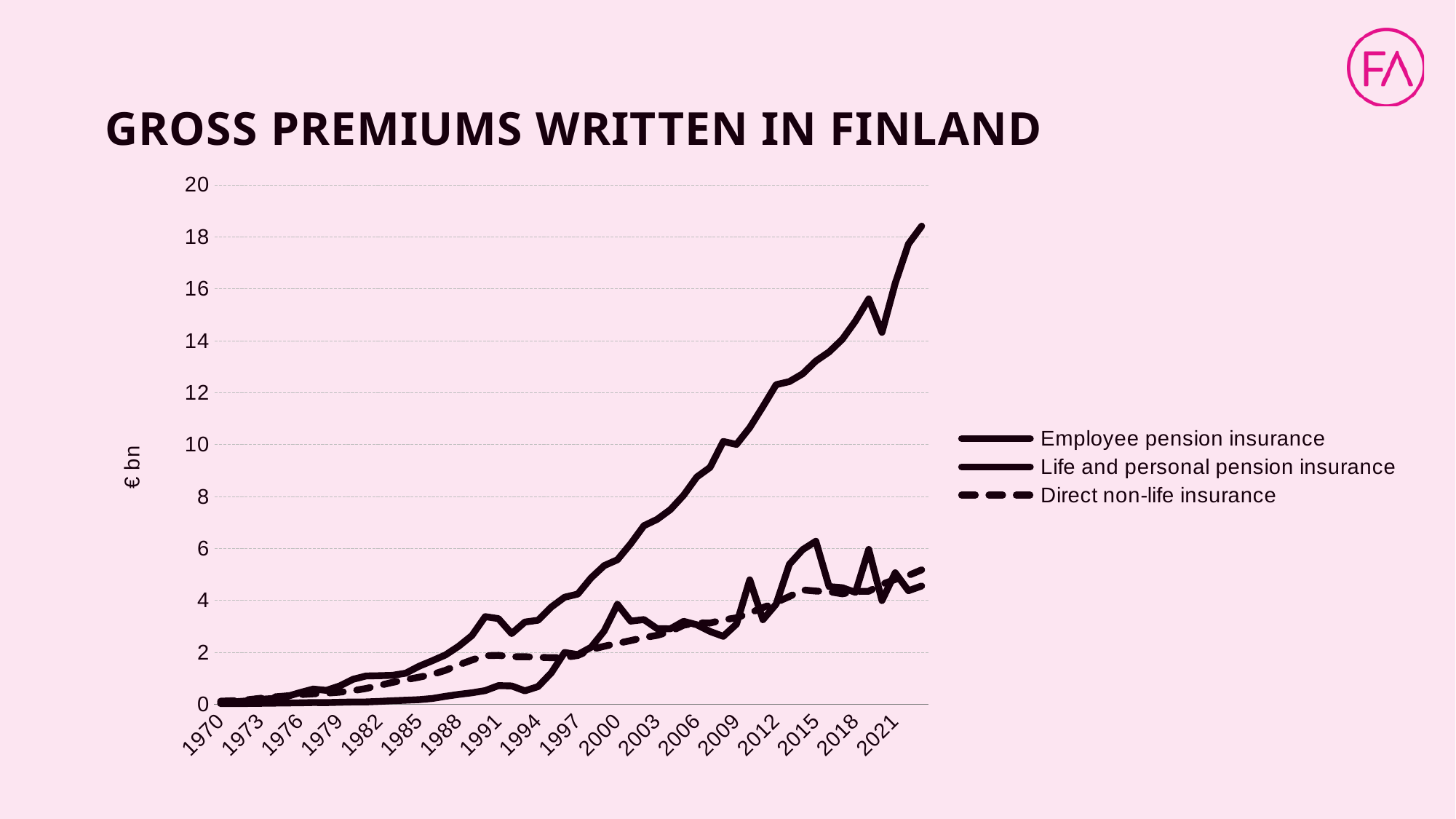
Which series is drawn with a dashed line? Direct non-life insurance What is the title of the chart? GROSS PREMIUMS WRITTEN IN FINLAND In 2021, which is larger: Employee pension insurance or Direct non-life insurance? Employee pension insurance What is the label on the vertical axis? € bn Is the value for Direct non-life insurance in 1991 greater or less than 4? less How many series does the legend list? 3 Is the value for Employee pension insurance at the right end of the chart greater or less than 16? greater Is the value for Employee pension insurance in 2000 greater or less than 4? greater Does the Employee pension insurance series generally rise or fall from 1970 to the end of the chart? rise Which series has the lowest value in 1991? Life and personal pension insurance Which series has the highest value at the right end of the chart? Employee pension insurance What kind of chart is shown on the slide? line chart